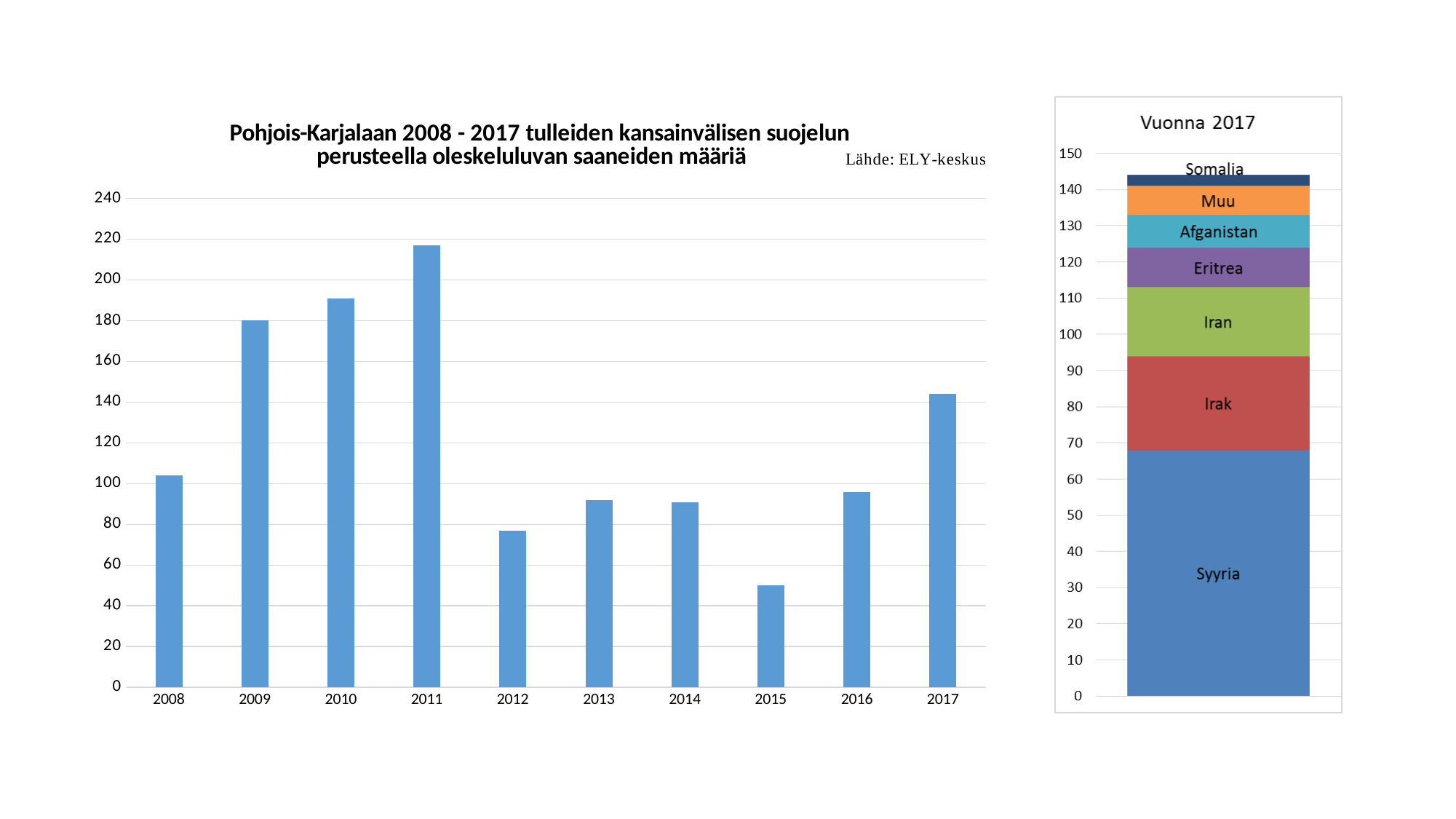
In the left chart, is the value for 2008 greater or less than 100? greater In the 'Vuonna 2017' chart on the right, which segment is the largest? Syyria How many years are shown on the x axis of the left chart? 10 What source is cited for the left chart? ELY-keskus In the left chart, is the value for 2015 greater or less than 60? less In the left chart, is the value for 2012 greater or less than 80? less In the left chart, do the values rise or fall from 2011 to 2015? fall In the left chart, which year has the lowest value? 2015 In the left chart, which year has the larger value, 2009 or 2010? 2010 What kind of chart is the chart on the left of the slide? bar chart In the left chart, which year has the highest value? 2011 In the 'Vuonna 2017' chart on the right, how many segments make up the stacked bar? 7